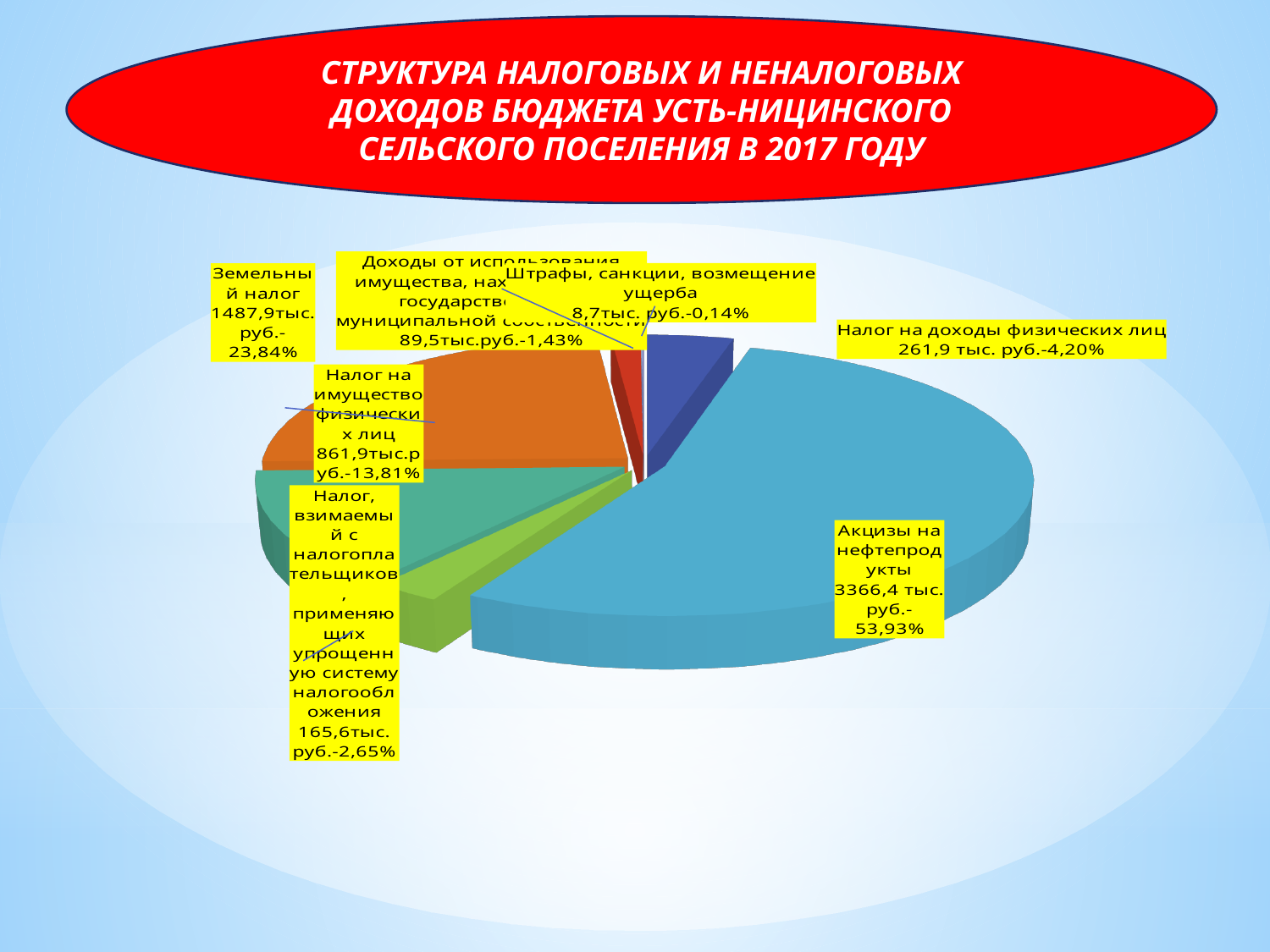
What kind of chart is shown on the slide? Pie chart What year does the chart title refer to? 2017 Which category has the largest share of the pie? Акцизы на нефтепродукты Which is larger: Земельный налог or Налог на имущество физических лиц? Земельный налог What is the difference in percentage points between Акцизы на нефтепродукты (53,93%) and Земельный налог (23,84%)? 30,09 Which category has the smallest share of the pie? Штрафы, санкции, возмещение ущерба What is the value shown for Налог на доходы физических лиц? 261,9 тыс. руб. What share of the pie does Акцизы на нефтепродукты represent? 53,93% What percentage is shown for Штрафы, санкции, возмещение ущерба? 0,14% What percentage is shown for Налог на имущество физических лиц? 13,81% What is the value shown for Земельный налог? 1487,9 тыс. руб. How many slices does the pie chart have? 7